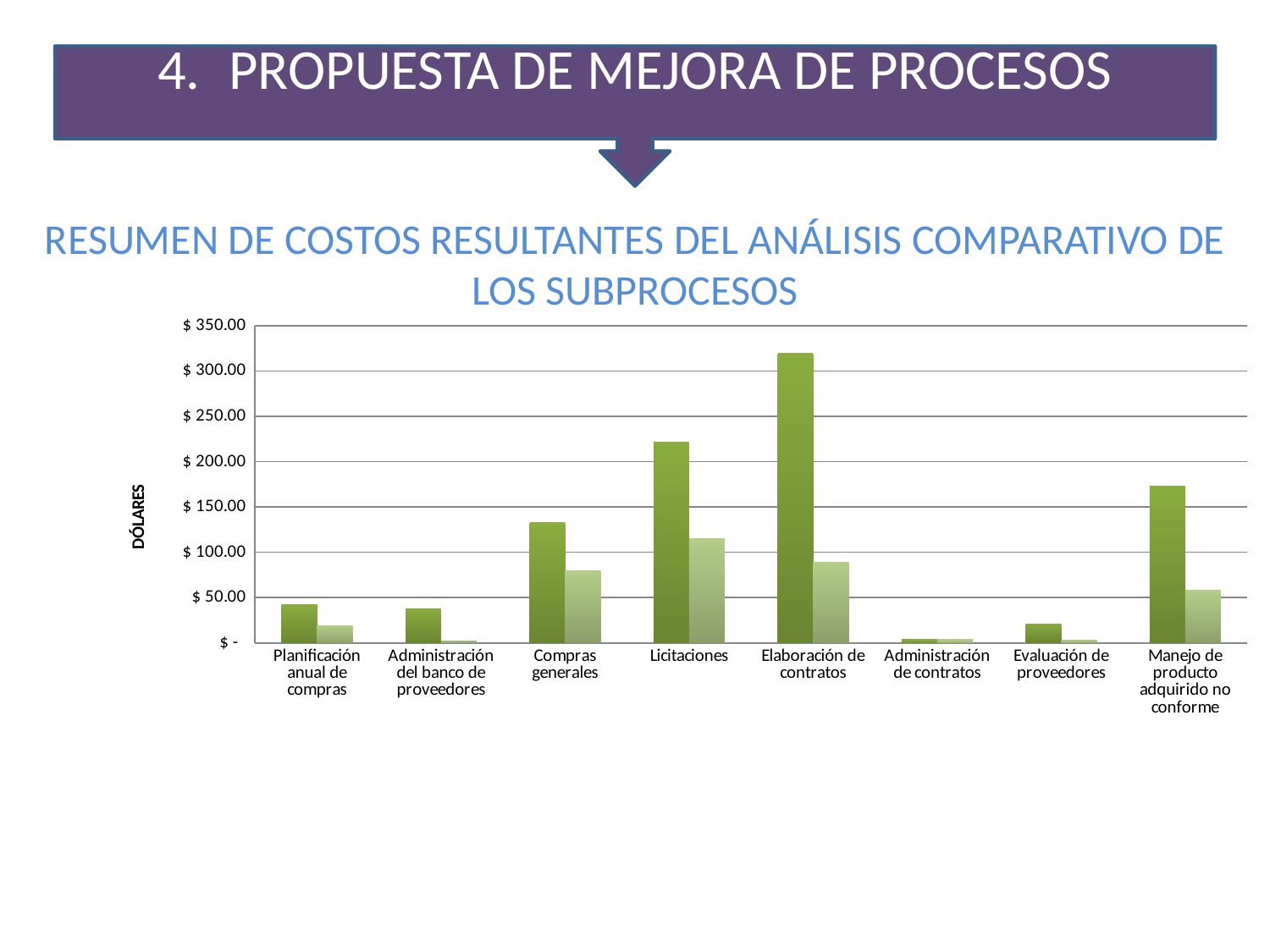
What is the title of the chart? RESUMEN DE COSTOS RESULTANTES DEL ANÁLISIS COMPARATIVO DE LOS SUBPROCESOS Which has the larger dark green bar, Licitaciones or Manejo de producto adquirido no conforme? Licitaciones Is the dark green bar for Licitaciones greater or less than $ 200.00? greater Which category has the shortest dark green bar? Administración de contratos Is the light green bar for Licitaciones greater or less than $ 100.00? greater What kind of chart is shown on the slide? bar chart How many subprocess categories are shown on the x axis of the chart? 8 Which category has the tallest dark green bar? Elaboración de contratos Is the dark green bar for Elaboración de contratos greater or less than $ 300.00? greater What is the label on the vertical axis of the chart? DÓLARES Which category has the tallest light green bar? Licitaciones